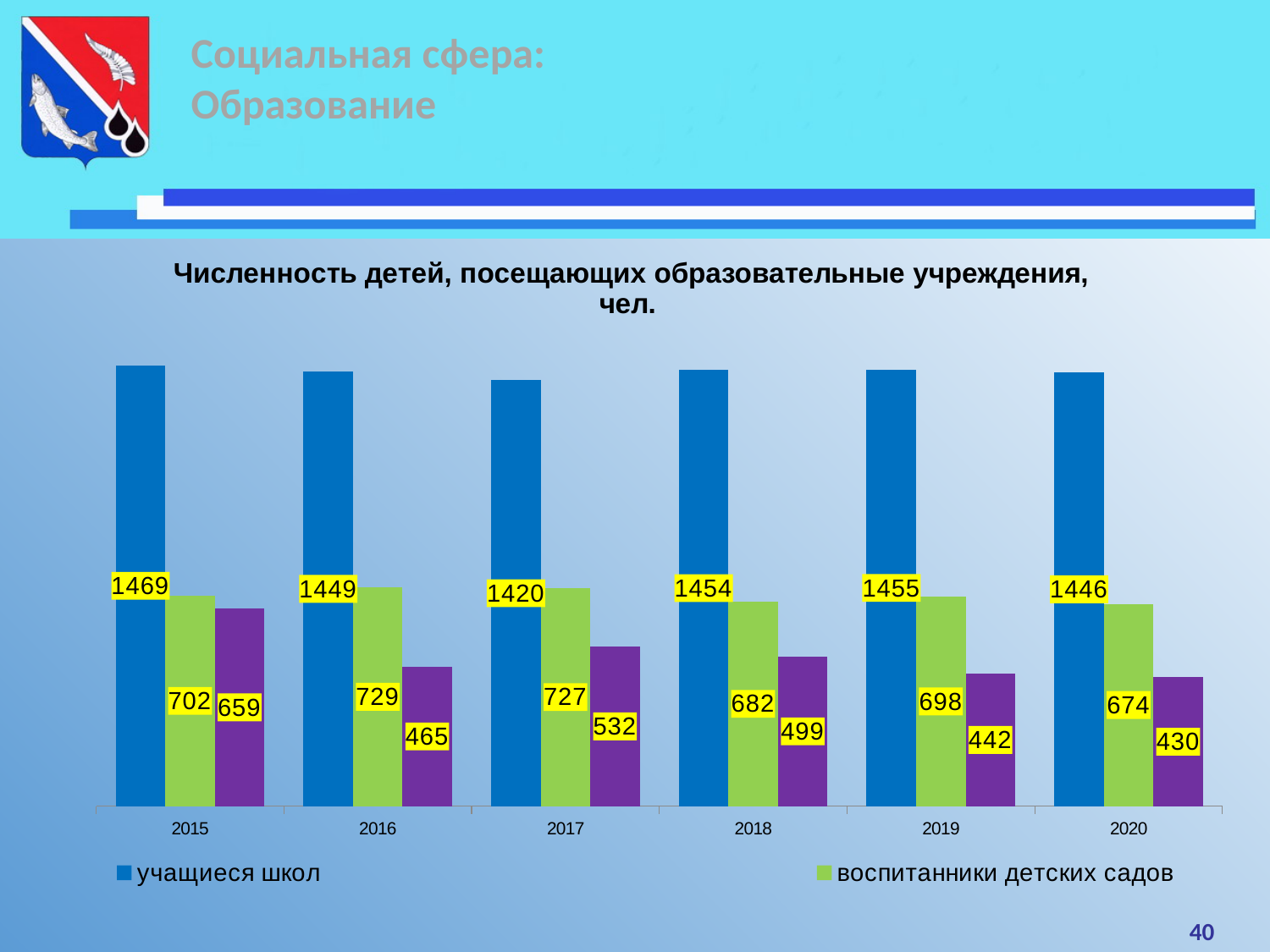
What is the value for учащиеся школ in 2020? 1446 In which year was the number of учащиеся школ lowest? 2017 What kind of chart is shown on the slide? bar chart How many series does the legend list? 2 In which year was the number of учащиеся школ highest? 2015 In which year was the number of воспитанники детских садов lowest? 2020 What is the difference between the number of учащиеся школ in 2015 and in 2016? 20 How many school pupils (учащиеся школ) were there in 2017? 1420 What is the difference between the number of воспитанники детских садов in 2016 and in 2020? 55 How many years are shown on the x axis of the chart? 6 Which is larger: the number of воспитанники детских садов in 2017 or in 2018? 2017 What is the number of kindergarten children (воспитанники детских садов) in 2016? 729